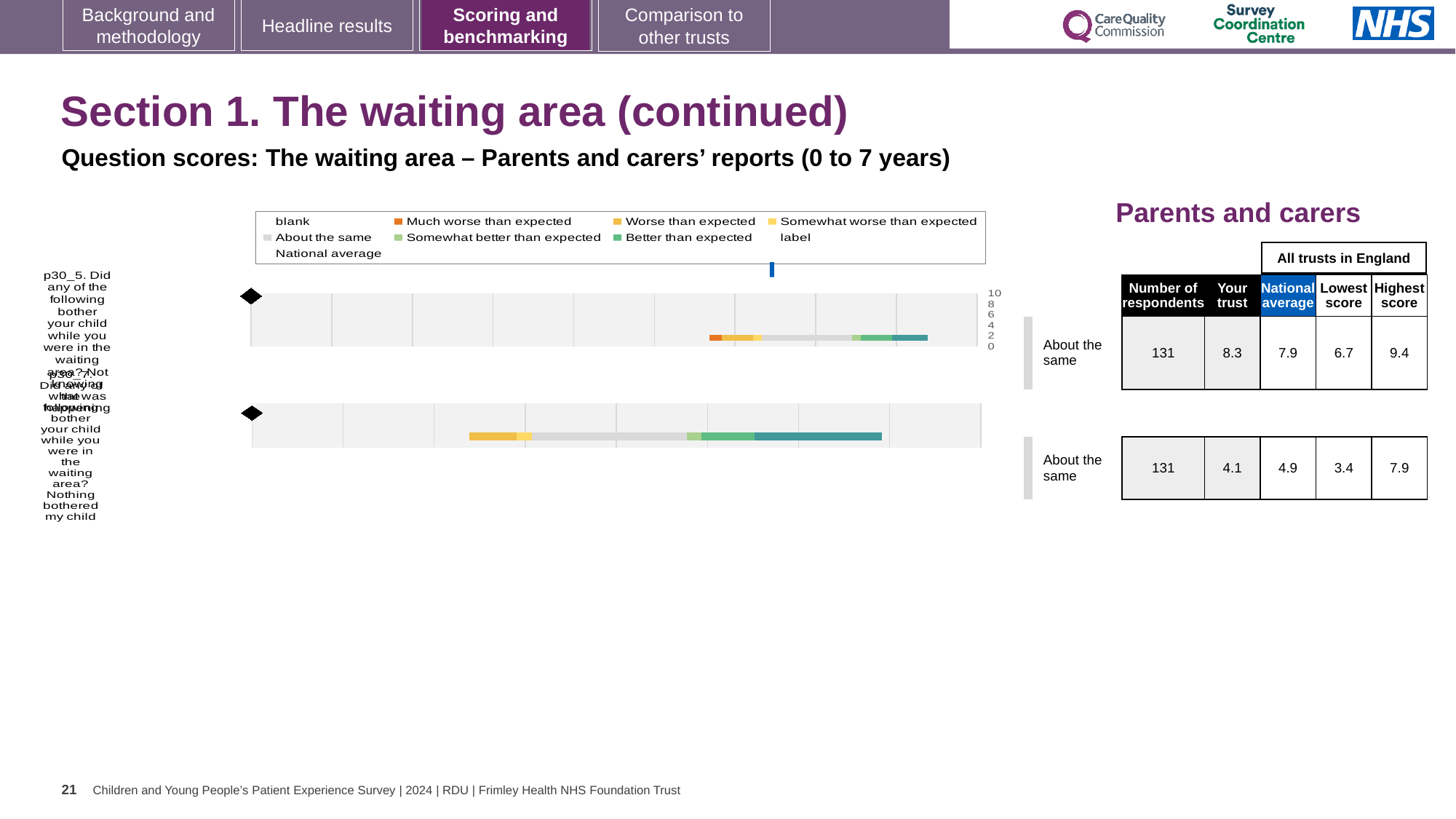
For question p30_5, what is the difference between the highest score and the lowest score in the table? 2.7 What benchmark category is shown for both questions next to the chart? About the same How many question bars are plotted in the chart? 2 For question p30_5, which is larger: the "Your trust" score or the national average? Your trust In the table beside the chart, how many respondents answered question p30_5? 131 How many entries does the chart legend list? 9 What kind of chart is shown on the slide? bar chart What colour does the legend use for "Much worse than expected"? orange Which question has the higher "Your trust" score, p30_5 or p30_7? p30_5 In the table beside the chart, what is the national average for question p30_7? 4.9 What is the highest value shown on the chart's numeric axis? 10 In the table beside the chart, what is the "Your trust" score for question p30_5? 8.3